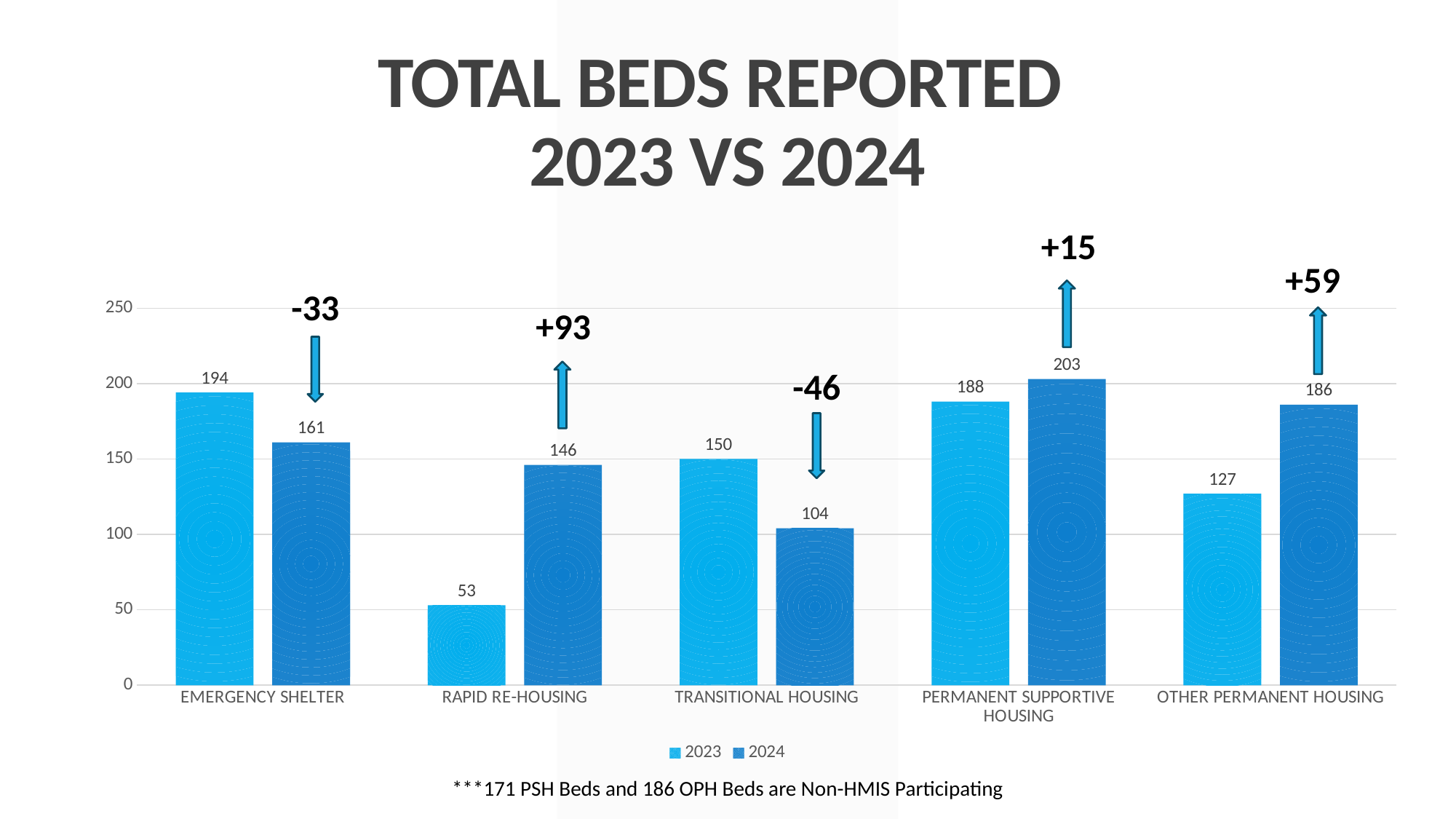
What kind of chart is shown on the slide? Bar chart What is the 2023 value for Emergency Shelter? 194 How many series does the legend list? 2 What change is annotated above the Permanent Supportive Housing bars? +15 Which is larger for Transitional Housing, the 2023 value or the 2024 value? 2023 How many categories are shown on the x axis? 5 Which category has the highest 2024 value? Permanent Supportive Housing Which category has the lowest 2023 value? Rapid Re-Housing What is the title of the chart? Total Beds Reported 2023 vs 2024 What is the 2024 value for Transitional Housing? 104 What is the difference between the 2024 and 2023 values for Other Permanent Housing? 59 What is the 2024 value for Rapid Re-Housing? 146